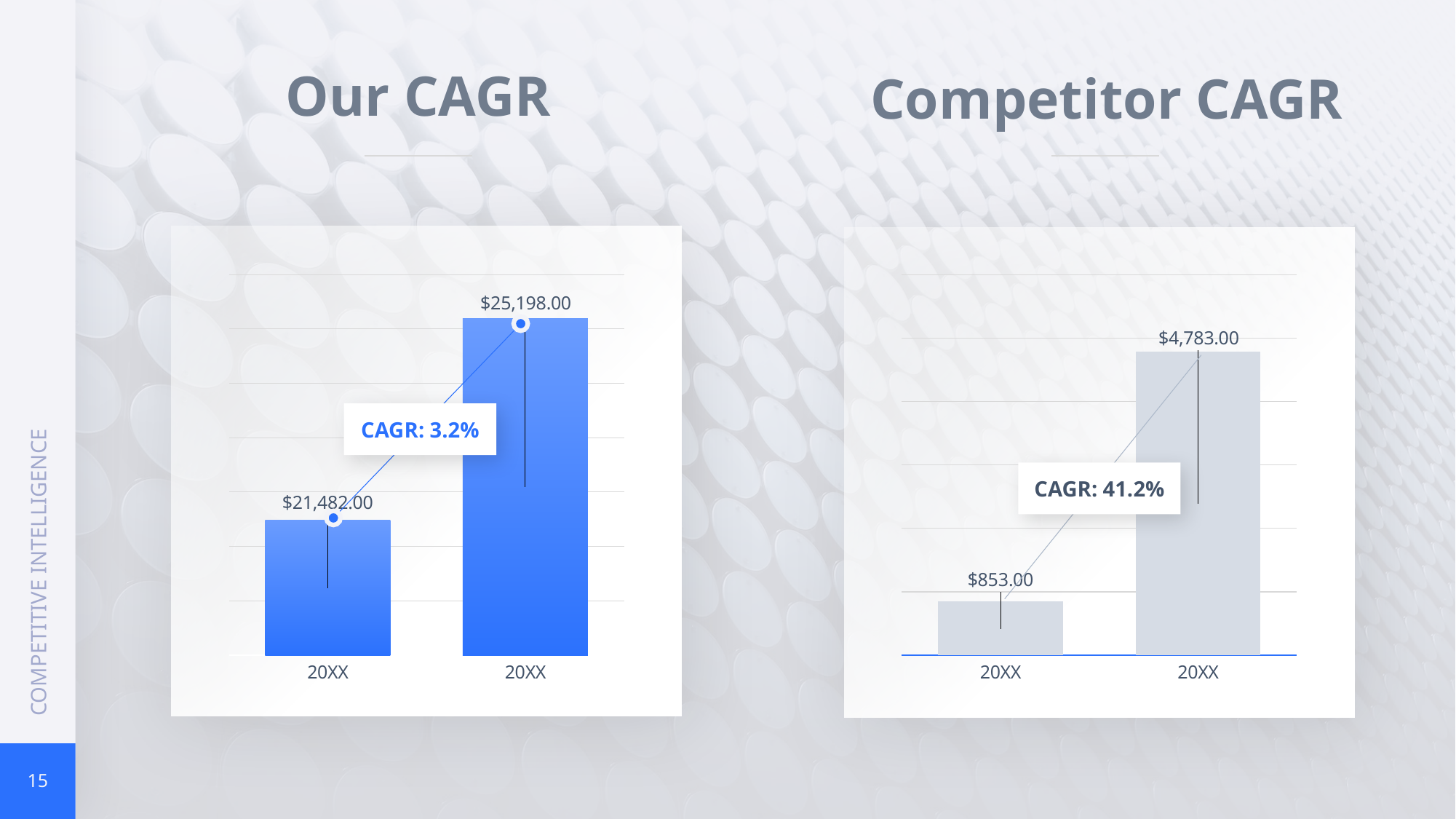
In the 'Our CAGR' chart, which bar is higher, the left one or the right one? the right one How many bars are plotted in the 'Competitor CAGR' chart? 2 In the 'Competitor CAGR' chart, what is the difference between the two bar values? $3,930.00 In the 'Our CAGR' chart, what is the value of the right (second) bar? $25,198.00 In the 'Competitor CAGR' chart, what is the value of the left (first) bar? $853.00 What CAGR percentage is shown in the callout on the 'Competitor CAGR' chart? 41.2% Do the values in the 'Competitor CAGR' chart rise or fall from left to right? rise In the 'Our CAGR' chart, what is the difference between the two bar values? $3,716.00 What kind of chart is the 'Our CAGR' chart? bar chart In the 'Our CAGR' chart, what is the value of the left (first) bar? $21,482.00 In the 'Competitor CAGR' chart, what is the value of the right (second) bar? $4,783.00 In the 'Competitor CAGR' chart, which bar is the lowest? the left (first) bar, $853.00